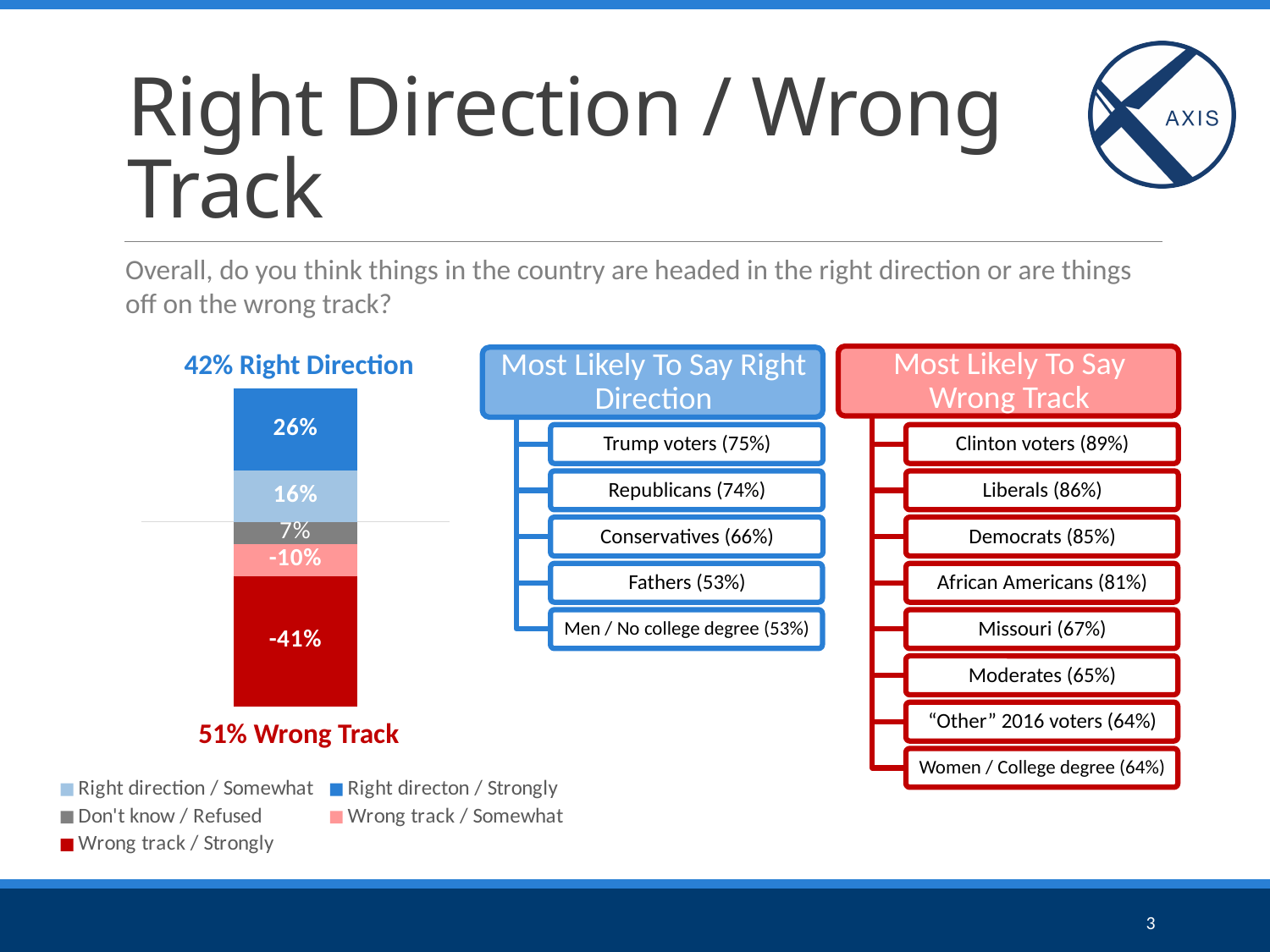
What is the value of the Wrong track / Strongly segment in the stacked bar? -41% What type of chart is shown on the slide? Stacked bar chart What is the difference between the Right directon / Strongly segment (26%) and the Right direction / Somewhat segment (16%)? 10% What total is labelled above the blue portion of the stacked bar? 42% Right Direction What is the value of the Wrong track / Somewhat segment in the stacked bar? -10% What is the value of the Right directon / Strongly segment in the stacked bar? 26% What is the value of the Right direction / Somewhat segment in the stacked bar? 16% Which segment of the stacked bar has the largest magnitude? Wrong track / Strongly How many series does the chart legend list? 5 Which segment of the stacked bar has the smallest magnitude? Don't know / Refused What is the value of the Don't know / Refused segment in the stacked bar? 7% What total is labelled below the red portion of the stacked bar? 51% Wrong Track